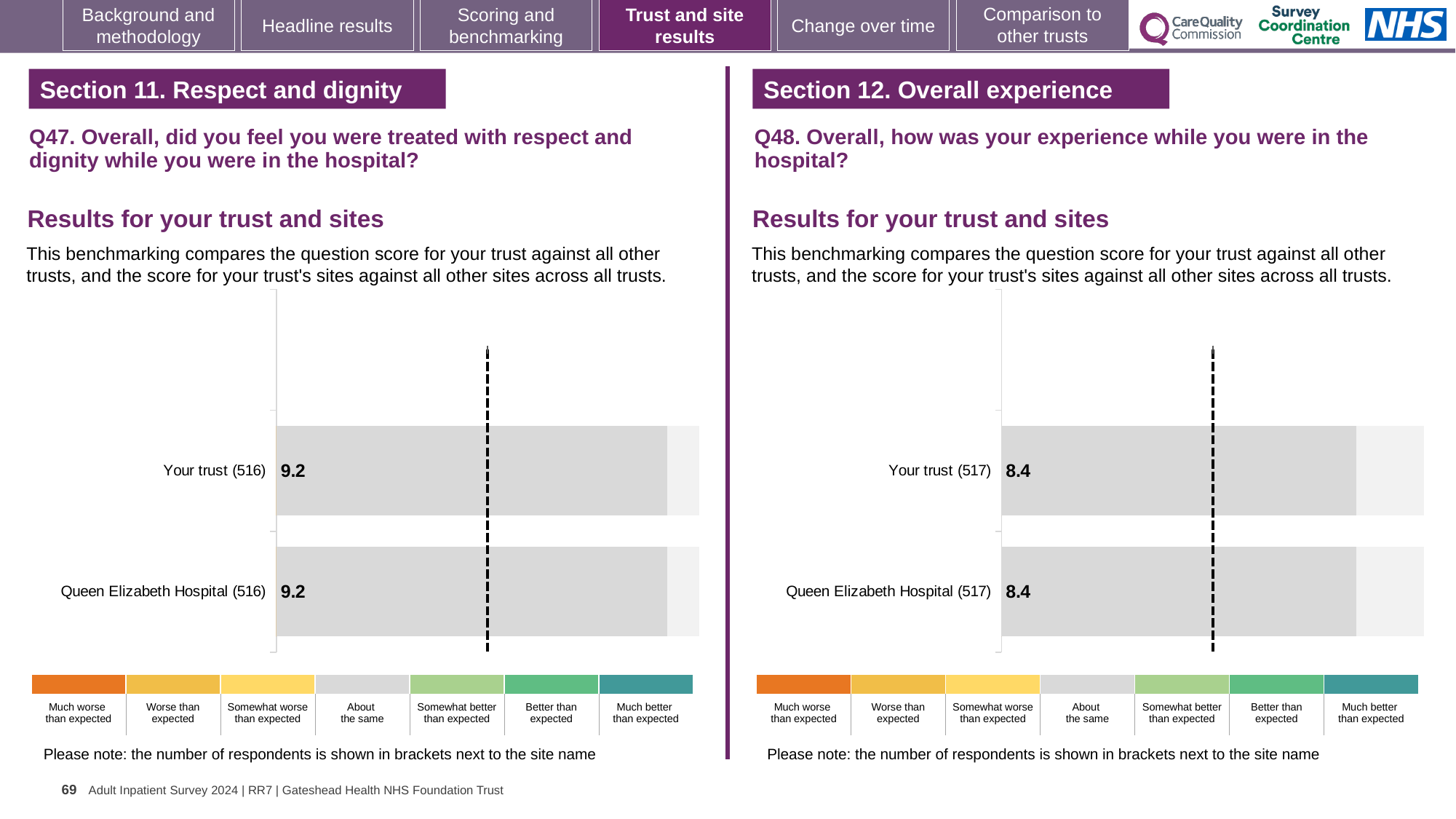
How many bars are plotted in the Q48 chart on the right? 2 In the Q47 chart on the left, how many respondents are shown in brackets next to Your trust? 516 In the Q48 chart on the right, how many respondents are shown in brackets next to Queen Elizabeth Hospital? 517 How many bars are plotted in the Q47 chart on the left? 2 In the Q48 chart on the right, what is the score for Your trust? 8.4 In the Q48 chart on the right, what is the score for Queen Elizabeth Hospital? 8.4 What kind of chart is used for the Q48 results on the right? Bar chart In the Q48 chart on the right, is the score for Your trust larger than, smaller than, or the same as the score for Queen Elizabeth Hospital? the same In the Q47 chart on the left, what is the score for Queen Elizabeth Hospital? 9.2 In the Q47 chart on the left, what is the score for Your trust? 9.2 In the Q47 chart on the left, what is the difference between the score for Your trust and the score for Queen Elizabeth Hospital? 0